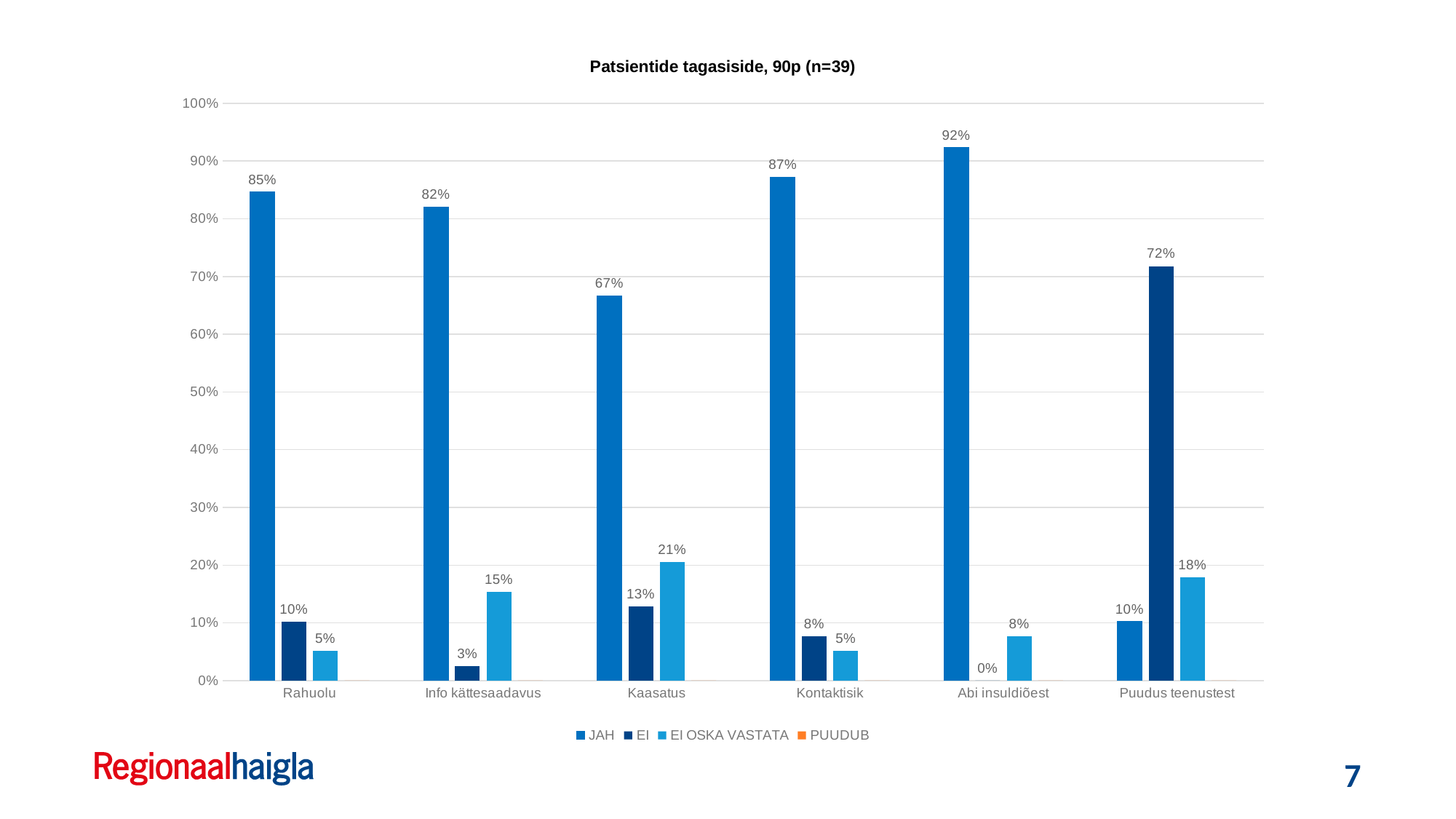
Which category has the highest JAH value? Abi insuldiõest Which category has the highest EI OSKA VASTATA value? Kaasatus What kind of chart is shown on the slide? Bar chart What is the EI value for Abi insuldiõest? 0% What is the title of the chart? Patsientide tagasiside, 90p (n=39) What is the JAH value for Kaasatus? 67% Which is larger: the EI OSKA VASTATA value for Kaasatus or for Info kättesaadavus? Kaasatus How many series does the legend list? 4 What is the difference between the JAH value for Abi insuldiõest and the JAH value for Kaasatus? 25 percentage points Which category has the lowest JAH value? Puudus teenustest How many categories are shown on the x axis? 6 What is the EI value for Puudus teenustest? 72%